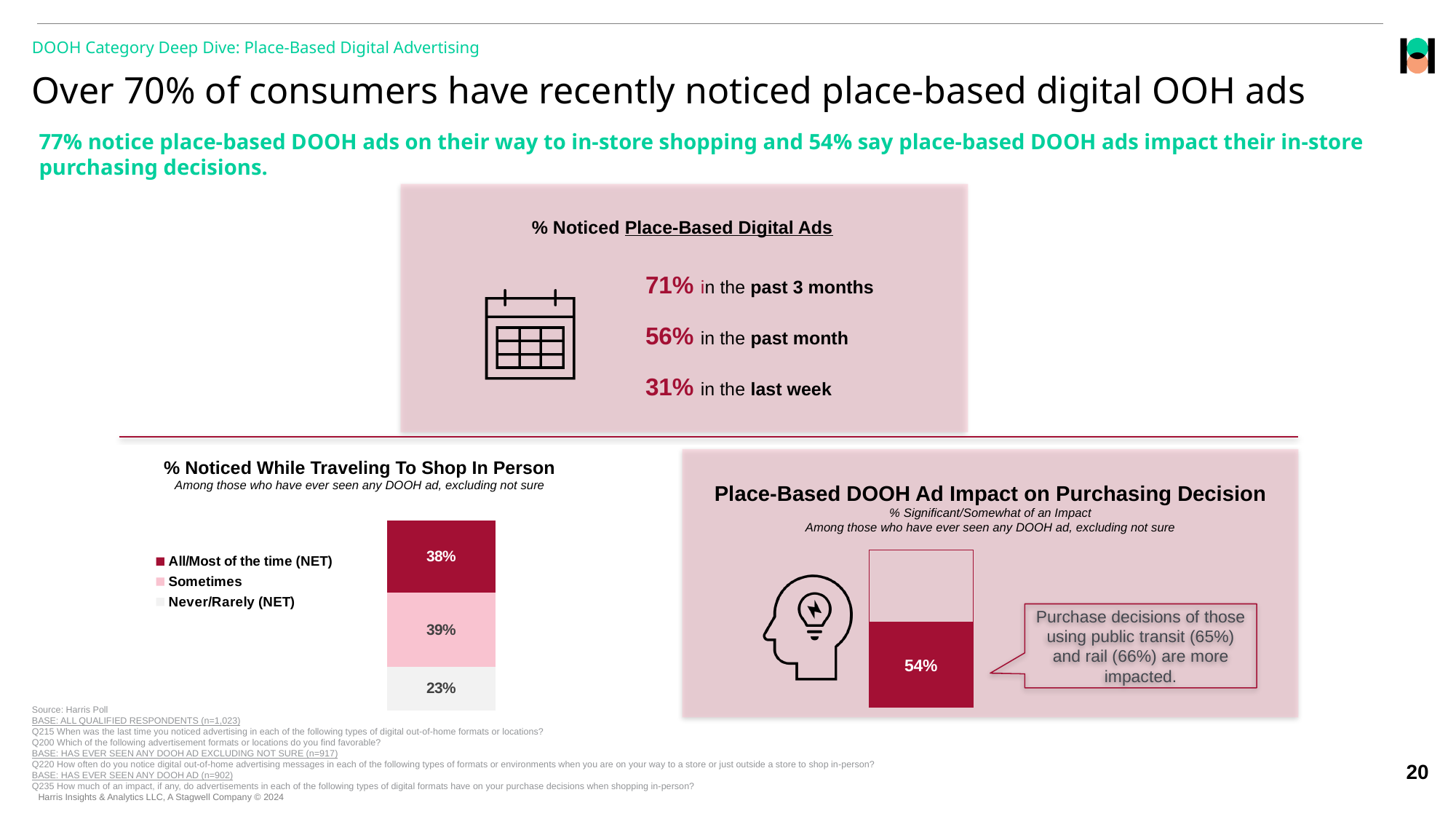
In the '% Noticed While Traveling To Shop In Person' chart, how many segments does the legend list? 3 In the '% Noticed While Traveling To Shop In Person' chart, what is the value for 'All/Most of the time (NET)'? 38% In the '% Noticed While Traveling To Shop In Person' chart, what is the value for 'Never/Rarely (NET)'? 23% In the 'Place-Based DOOH Ad Impact on Purchasing Decision' chart, is the value shown greater or less than 50%? greater In the 'Place-Based DOOH Ad Impact on Purchasing Decision' chart, what percentage is shown on the bar? 54% In the '% Noticed While Traveling To Shop In Person' chart, which legend entry is shown in dark red? All/Most of the time (NET) In the '% Noticed While Traveling To Shop In Person' chart, which segment has the smallest value? Never/Rarely (NET) In the '% Noticed While Traveling To Shop In Person' chart, what is the value for 'Sometimes'? 39% In the '% Noticed While Traveling To Shop In Person' chart, what is the difference between the 'Sometimes' and 'Never/Rarely (NET)' values? 16% Which is larger: the 'All/Most of the time (NET)' value in the '% Noticed While Traveling To Shop In Person' chart or the value in the 'Place-Based DOOH Ad Impact on Purchasing Decision' chart? Place-Based DOOH Ad Impact on Purchasing Decision (54%) In the '% Noticed While Traveling To Shop In Person' chart, what is the total of the three stacked segments? 100% What kind of chart is the '% Noticed While Traveling To Shop In Person' chart? Stacked bar chart